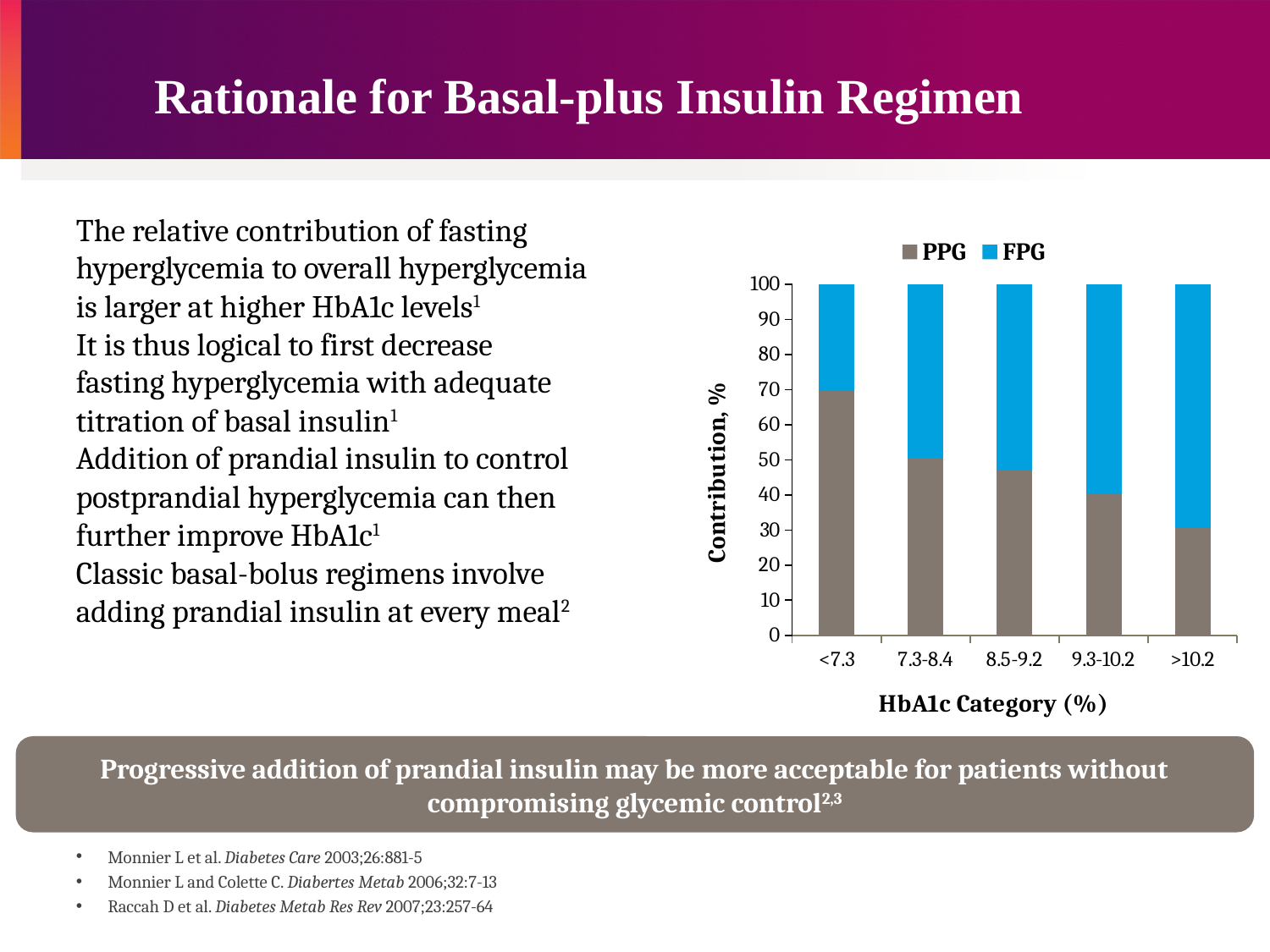
Which HbA1c category has the highest PPG contribution? <7.3 Is the PPG contribution for the <7.3 category greater or less than 60? greater What is the title of the y axis of the chart? Contribution, % How many HbA1c categories are shown on the x axis of the chart? 5 Which HbA1c category has the largest FPG contribution? >10.2 What kind of chart is shown on the slide? Stacked bar chart Is the PPG contribution for the 8.5-9.2 category greater or less than 60? less Does the PPG contribution rise or fall as the HbA1c category increases along the x axis? Fall Which is larger, the PPG contribution for <7.3 or for >10.2? <7.3 Which HbA1c category has the lowest PPG contribution? >10.2 How many series does the chart legend list? 2 Is the PPG contribution for the >10.2 category greater or less than 40? less